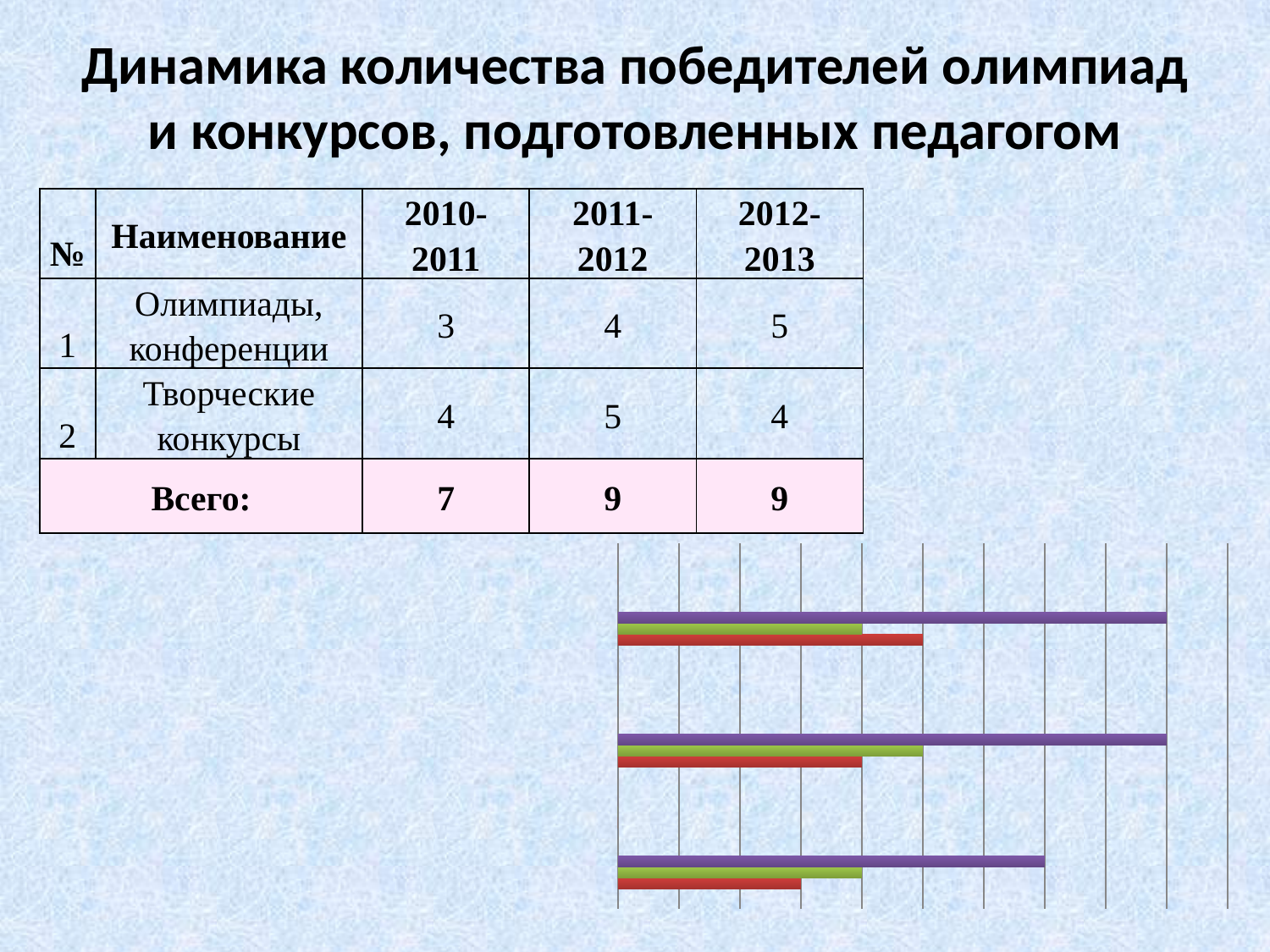
Which group of bars in the chart has the shortest purple bar? the bottom group Does the chart display a legend? No How many groups of bars does the chart contain? 3 Are the bars in the chart horizontal or vertical? horizontal Which colour bar is the shortest in the bottom group of the chart? red In the top group of the chart, is the red bar longer or shorter than the green bar? longer In the middle group of the chart, is the green bar longer or shorter than the red bar? longer How many bars are there in each group of the chart? 3 What kind of chart is shown on the slide? bar chart